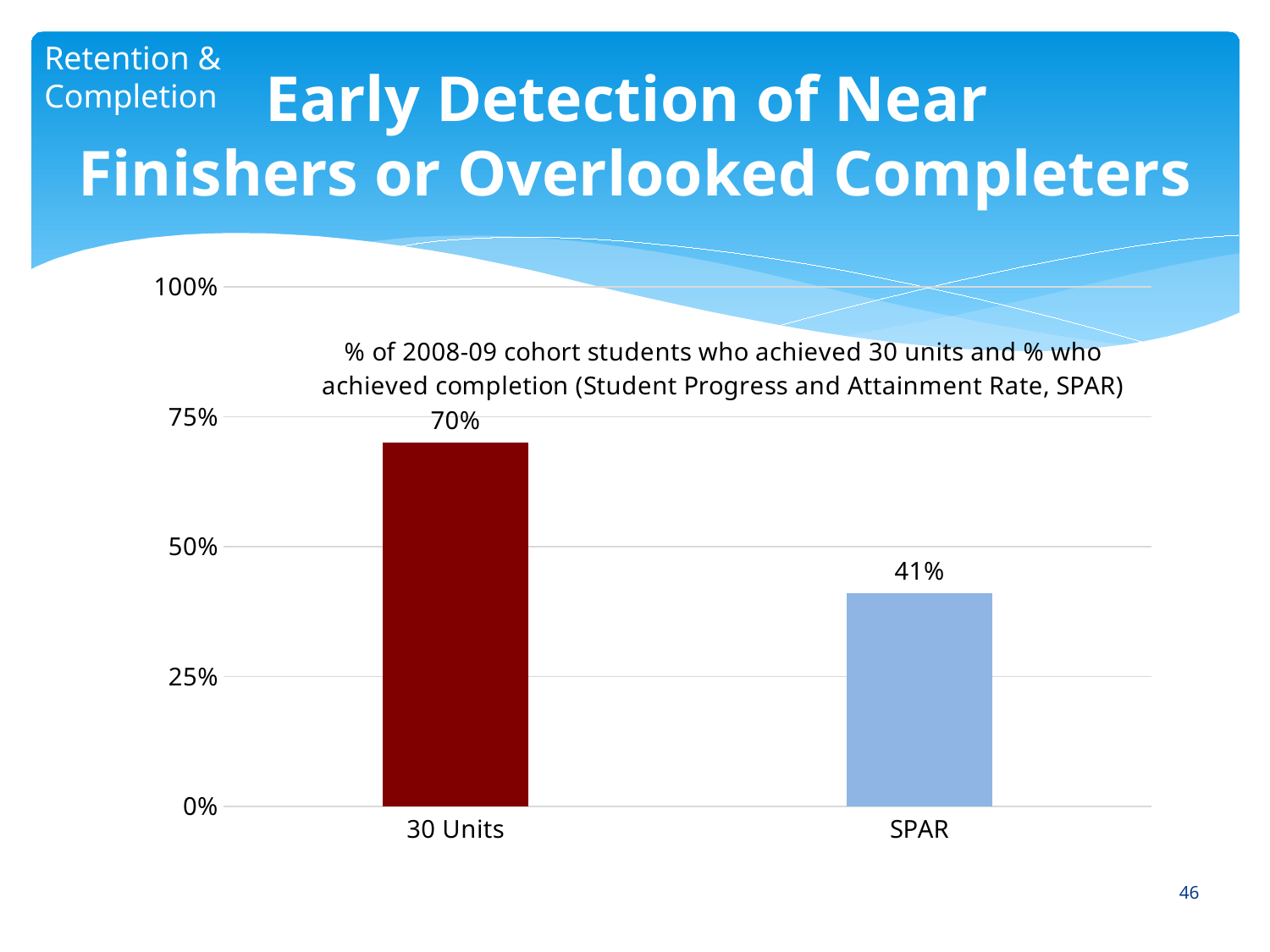
What is the value for SPAR? 41% Which is larger, the value for 30 Units or the value for SPAR? 30 Units What is the value for 30 Units? 70% Which category has the lowest value? SPAR Which category has the highest value? 30 Units How many categories are shown on the x axis? 2 Is the value for SPAR greater or less than 50%? less What kind of chart is shown on the slide? bar chart Is the value for 30 Units greater or less than 50%? greater What colour is the bar for 30 Units? dark red What is the highest value shown on the y axis? 100% What is the difference between the value for 30 Units and the value for SPAR? 29%